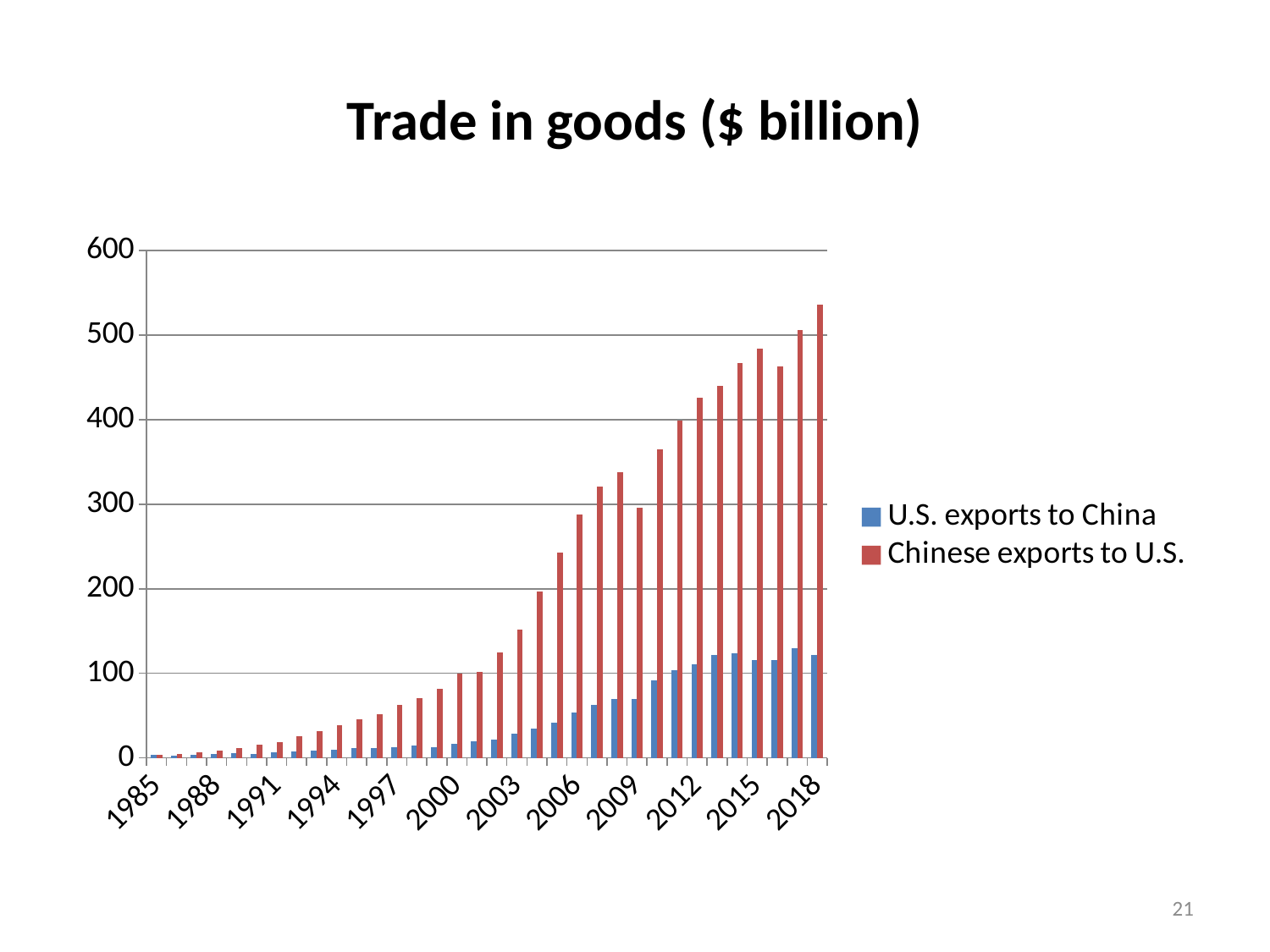
Is the value for Chinese exports to U.S. in 2018 greater or less than 500? greater Is the value for Chinese exports to U.S. in 2012 greater or less than 400? greater Is the value for U.S. exports to China in 2009 greater or less than 100? less What is the title of the chart? Trade in goods ($ billion) Do Chinese exports to U.S. generally rise or fall from 1985 to 2018? Rise How many series does the legend list? 2 Which series is shown in red? Chinese exports to U.S. In 2018, which is larger: U.S. exports to China or Chinese exports to U.S.? Chinese exports to U.S. What kind of chart is shown on the slide? Bar chart In which year are Chinese exports to U.S. highest? 2018